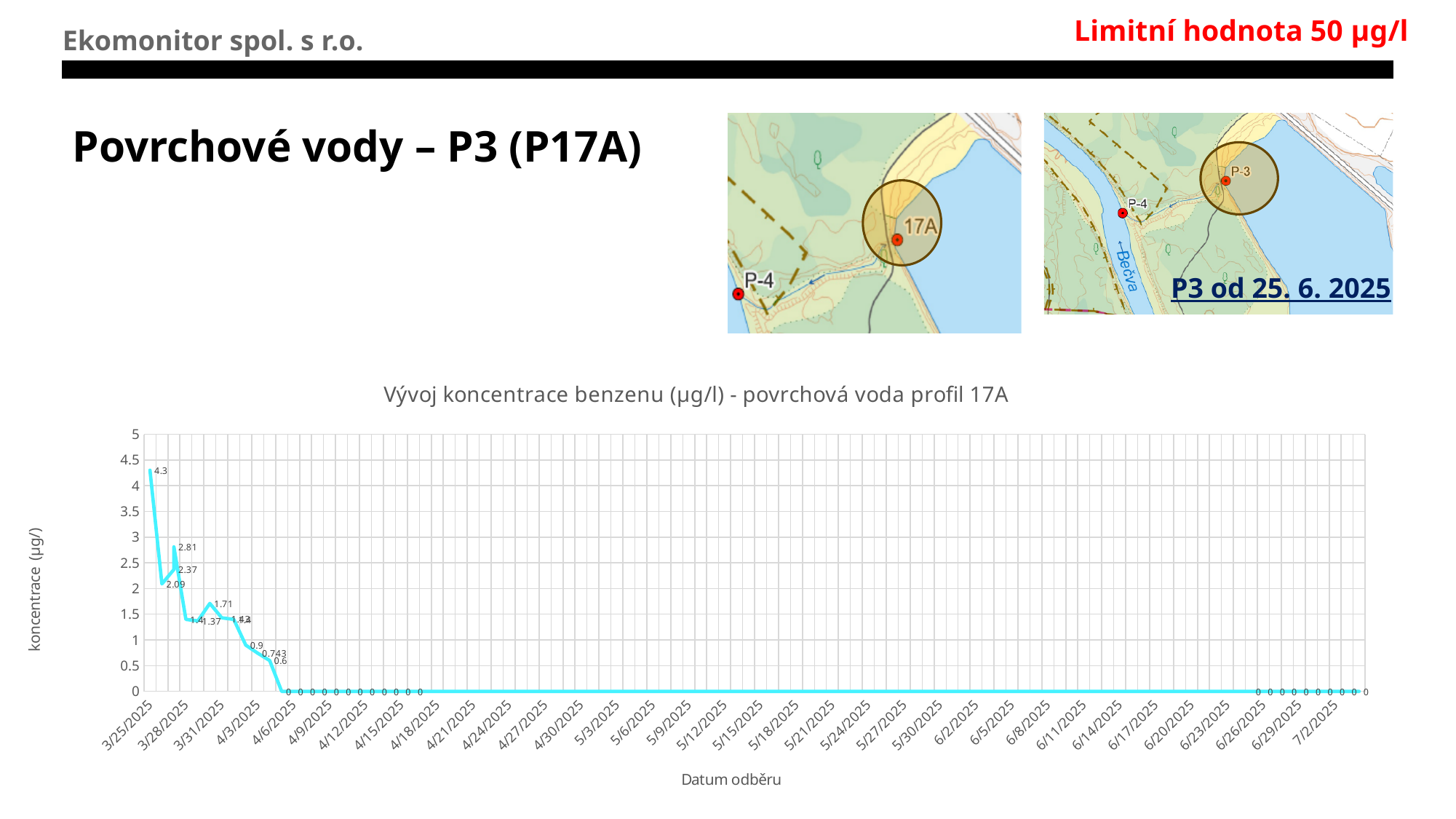
Which is larger, the value on 3/25/2025 or the value on 4/9/2025? 3/25/2025 What is the highest tick value shown on the vertical axis? 5 What is the label of the vertical axis of the chart? koncentrace (µg/l) What is the title of the chart? Vývoj koncentrace benzenu (µg/l) - povrchová voda profil 17A Do the values generally rise or fall along the x axis from 3/25/2025 onward? fall Is the value for 3/25/2025 greater or less than 4? greater By how much does the highest value (4.3) exceed the second-highest labeled value (2.81)? 1.49 What is the highest value plotted on the chart? 4.3 What is the benzene concentration on 3/25/2025? 4.3 What kind of chart is shown on the slide? line chart